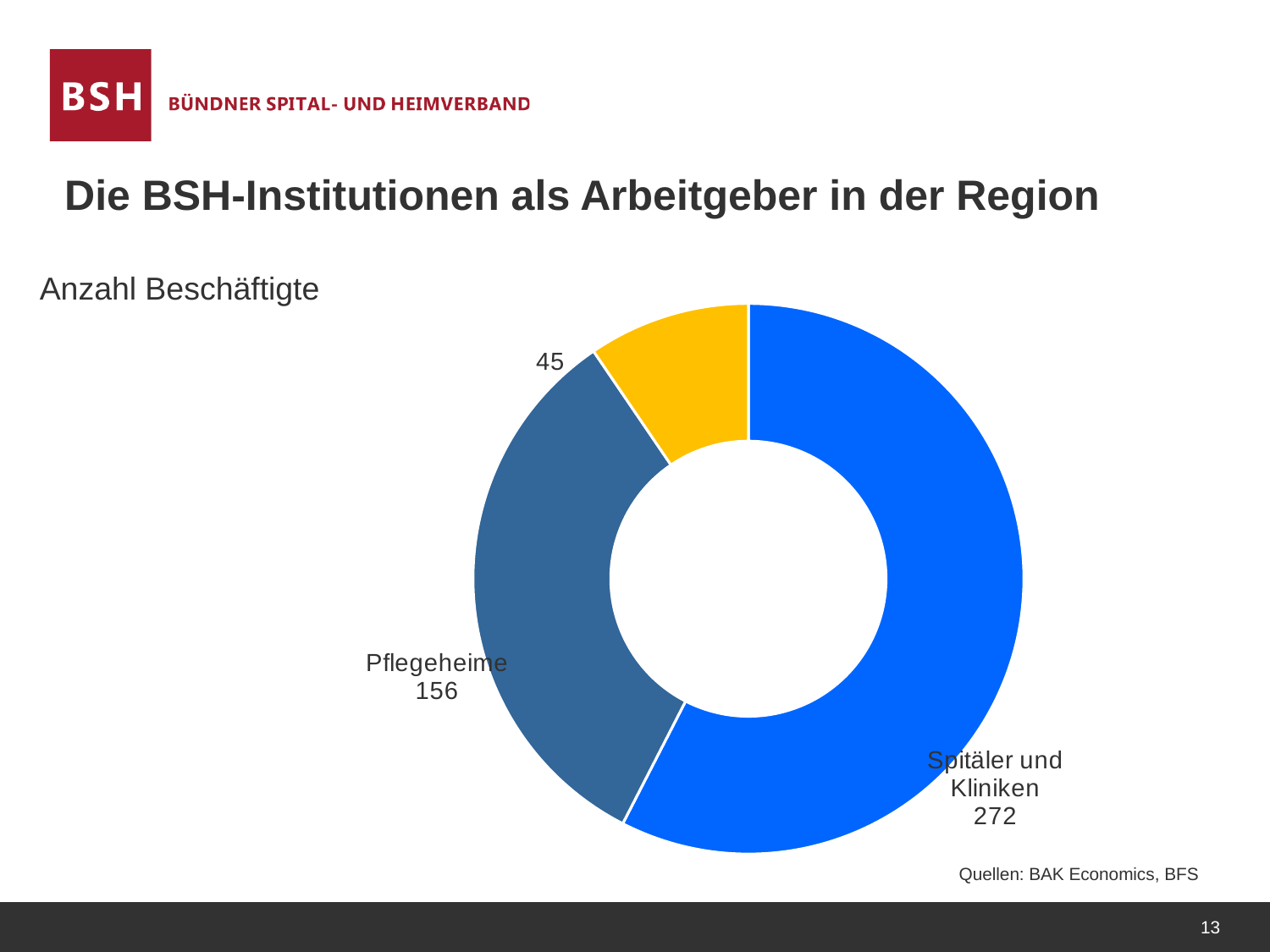
What is the smallest value shown on the chart? 45 What is the total of all three values shown on the chart? 473 What kind of chart is shown on the slide? Doughnut (pie) chart What is the label above the chart describing what is plotted? Anzahl Beschäftigte Which category has the largest slice of the doughnut chart? Spitäler und Kliniken What value is shown for Pflegeheime? 156 What is the difference between the values for Spitäler und Kliniken and Pflegeheime? 116 What colour is the slice for Spitäler und Kliniken? Blue How many slices does the doughnut chart have? 3 Which is larger, the value for Spitäler und Kliniken or the value for Pflegeheime? Spitäler und Kliniken What is the difference between the value for Pflegeheime and the smallest slice (45)? 111 What is the number of employees (Anzahl Beschäftigte) shown for Spitäler und Kliniken? 272